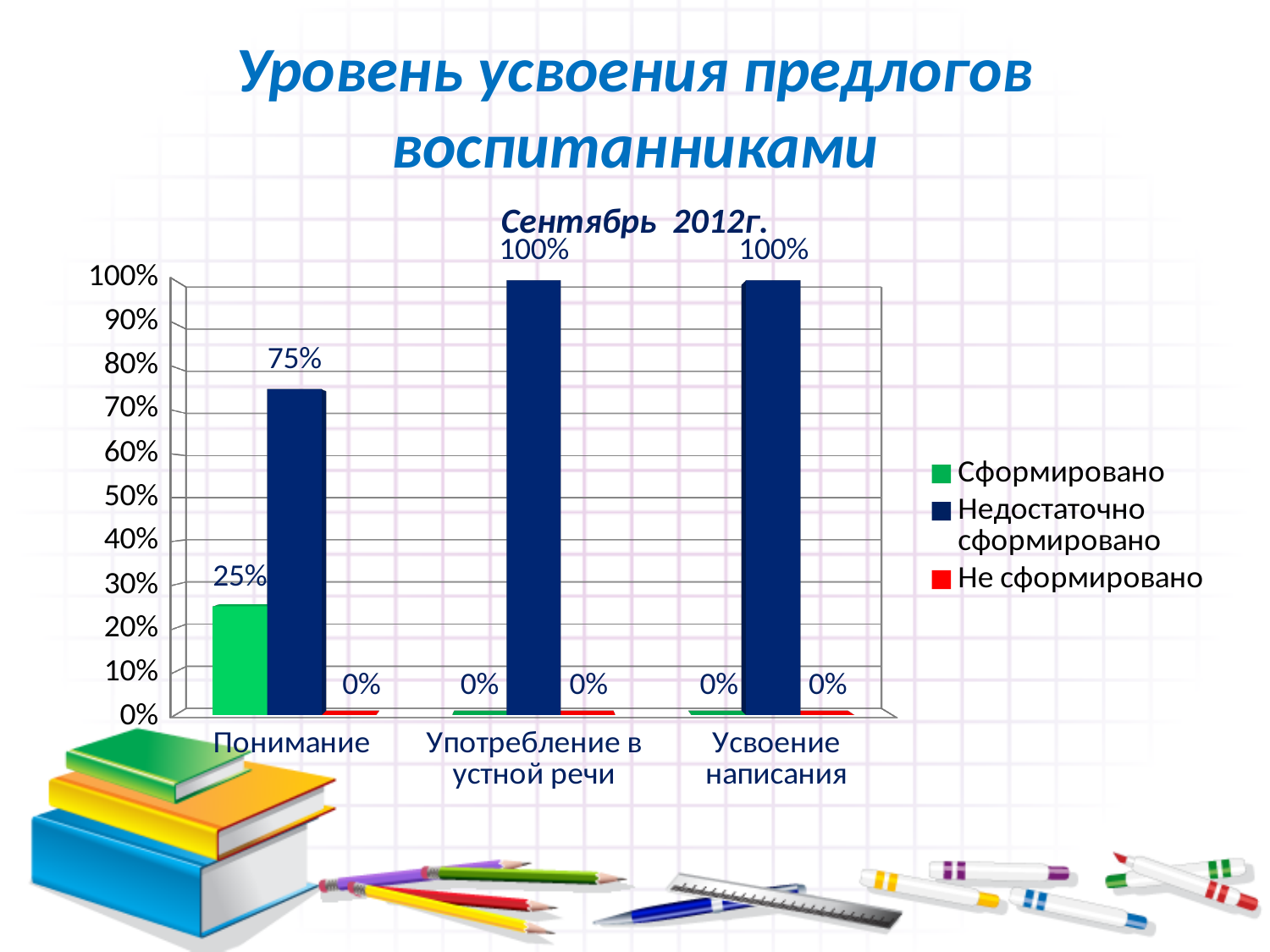
What is the subtitle shown above the chart? Сентябрь 2012г. How many categories are shown on the x axis? 3 What is the value for "Не сформировано" in the "Усвоение написания" category? 0% What is the value for "Недостаточно сформировано" in the "Употребление в устной речи" category? 100% What is the value for "Недостаточно сформировано" in the "Понимание" category? 75% In which category is the "Сформировано" value highest? Понимание What is the difference between the "Недостаточно сформировано" and "Сформировано" values in the "Понимание" category? 50% Which is larger in the "Понимание" category: "Сформировано" or "Недостаточно сформировано"? Недостаточно сформировано What kind of chart is shown on the slide? Bar chart How many series does the legend list? 3 In which category is the "Недостаточно сформировано" value lowest? Понимание What is the value for "Сформировано" in the "Понимание" category? 25%